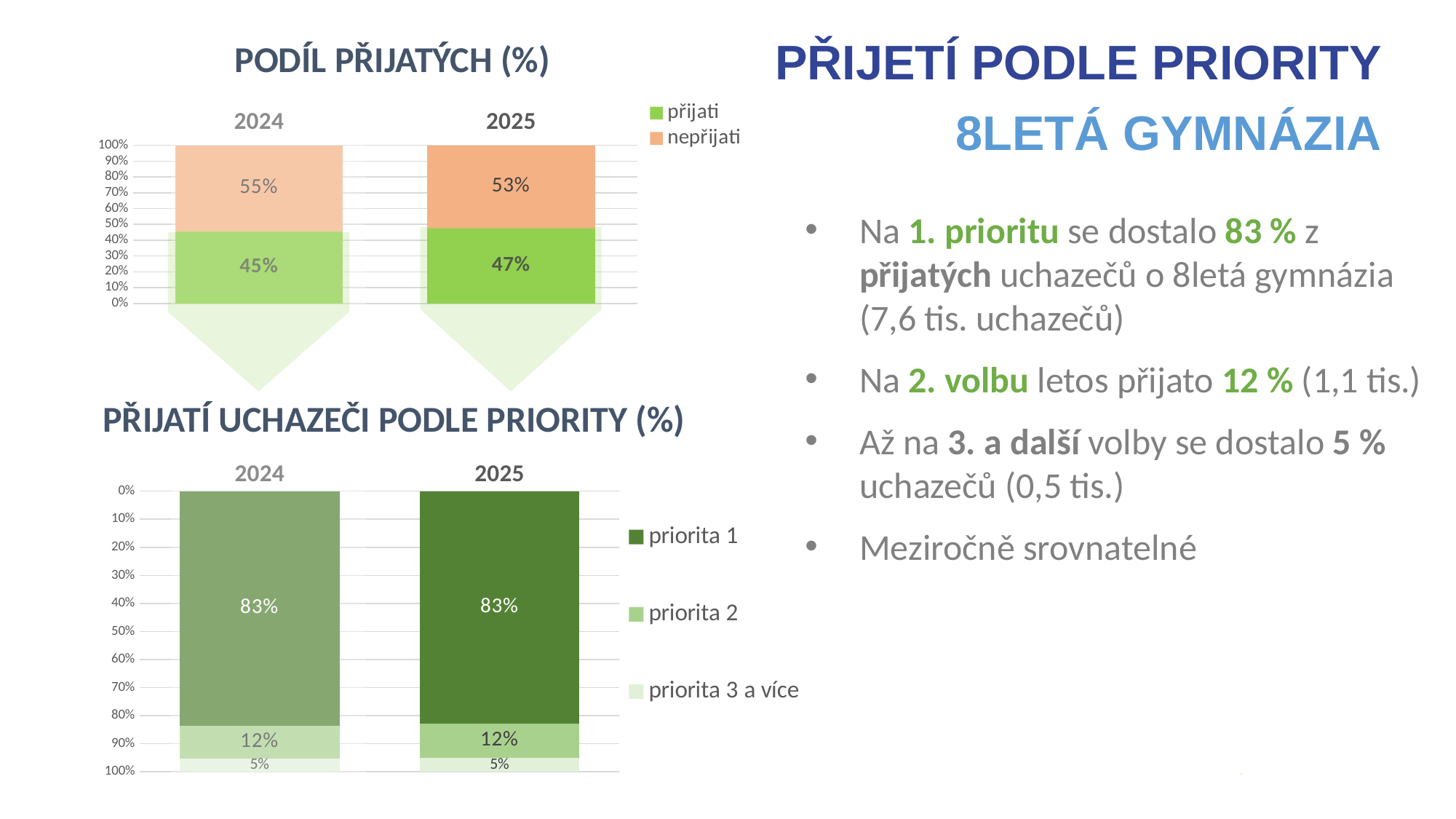
In the chart titled 'PODÍL PŘIJATÝCH (%)', is the 'přijati' share larger in 2024 or in 2025? 2025 In the chart titled 'PODÍL PŘIJATÝCH (%)', by how many percentage points does 'nepřijati' exceed 'přijati' in 2024? 10% In the chart titled 'PŘIJATÍ UCHAZEČI PODLE PRIORITY (%)', what is the value for 'priorita 3 a více' in 2024? 5% In the chart titled 'PODÍL PŘIJATÝCH (%)', what is the value for 'přijati' in 2024? 45% In the chart titled 'PODÍL PŘIJATÝCH (%)', what is the value for 'nepřijati' in 2025? 53% In the chart titled 'PODÍL PŘIJATÝCH (%)', does the 'přijati' share rise or fall from 2024 to 2025? rise In the chart titled 'PODÍL PŘIJATÝCH (%)', how many series does the legend list? 2 In the chart titled 'PŘIJATÍ UCHAZEČI PODLE PRIORITY (%)', which priority has the lowest share in 2025? priorita 3 a více What type of chart is the chart titled 'PŘIJATÍ UCHAZEČI PODLE PRIORITY (%)'? stacked bar chart In the chart titled 'PŘIJATÍ UCHAZEČI PODLE PRIORITY (%)', what is the value for 'prioritа 1' in 2025? 83% In the chart titled 'PŘIJATÍ UCHAZEČI PODLE PRIORITY (%)', what is the difference between 'priorita 1' and 'priorita 2' in 2024? 71% In the chart titled 'PŘIJATÍ UCHAZEČI PODLE PRIORITY (%)', how many series does the legend list? 3